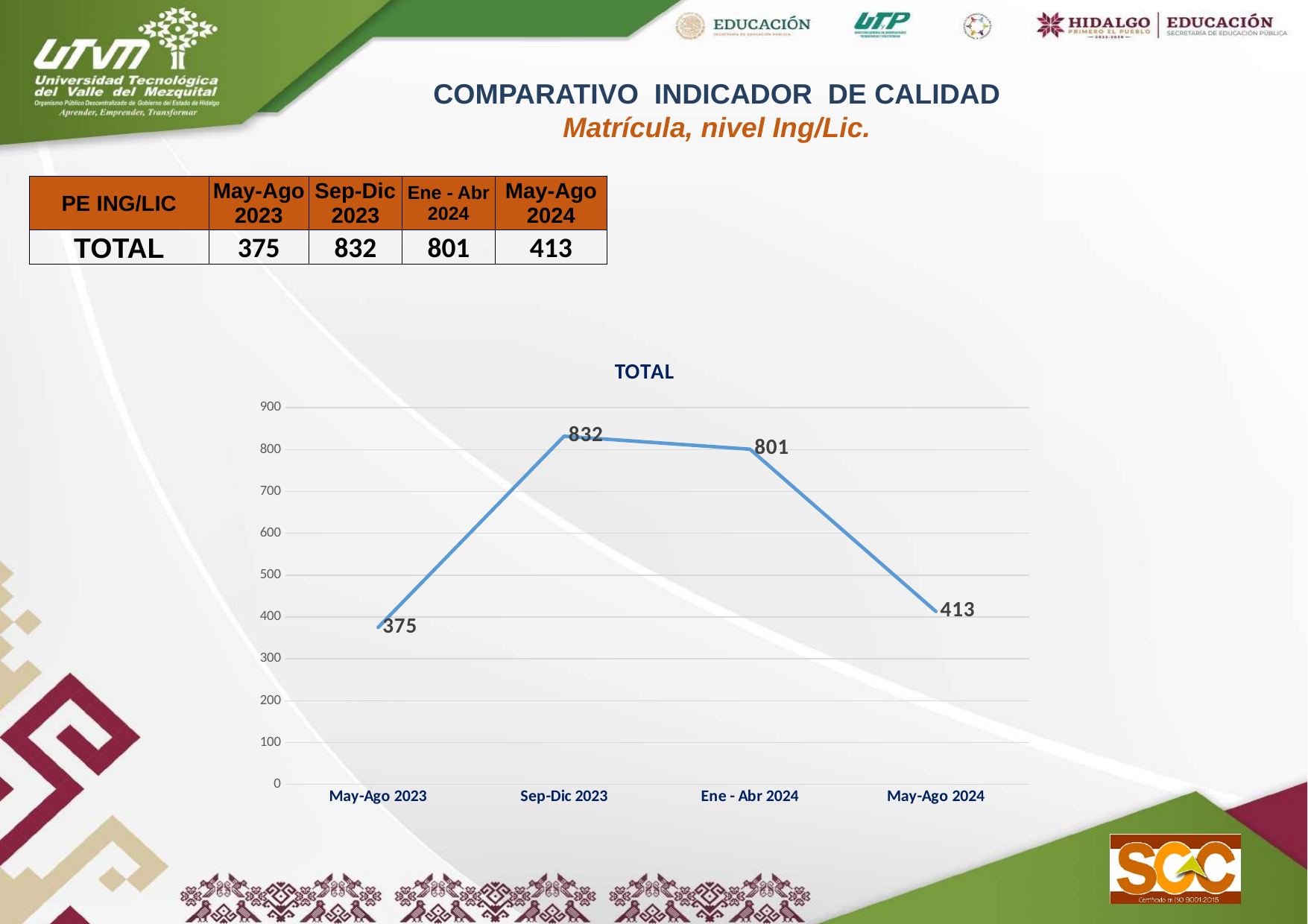
Which is larger, the value for May-Ago 2023 or the value for May-Ago 2024? May-Ago 2024 What is the value for Sep-Dic 2023 in the TOTAL chart? 832 What is the value for Ene - Abr 2024 in the TOTAL chart? 801 Which period has the highest value in the TOTAL chart? Sep-Dic 2023 Which period has the lowest value in the TOTAL chart? May-Ago 2023 What kind of chart is shown on the slide? line chart Is the value for Ene - Abr 2024 greater or less than 700? greater What is the difference between the values for Sep-Dic 2023 and Ene - Abr 2024? 31 What is the title of the chart? TOTAL What is the value for May-Ago 2024 in the TOTAL chart? 413 How many periods are plotted on the x axis of the chart? 4 What is the difference between the values for May-Ago 2024 and May-Ago 2023? 38